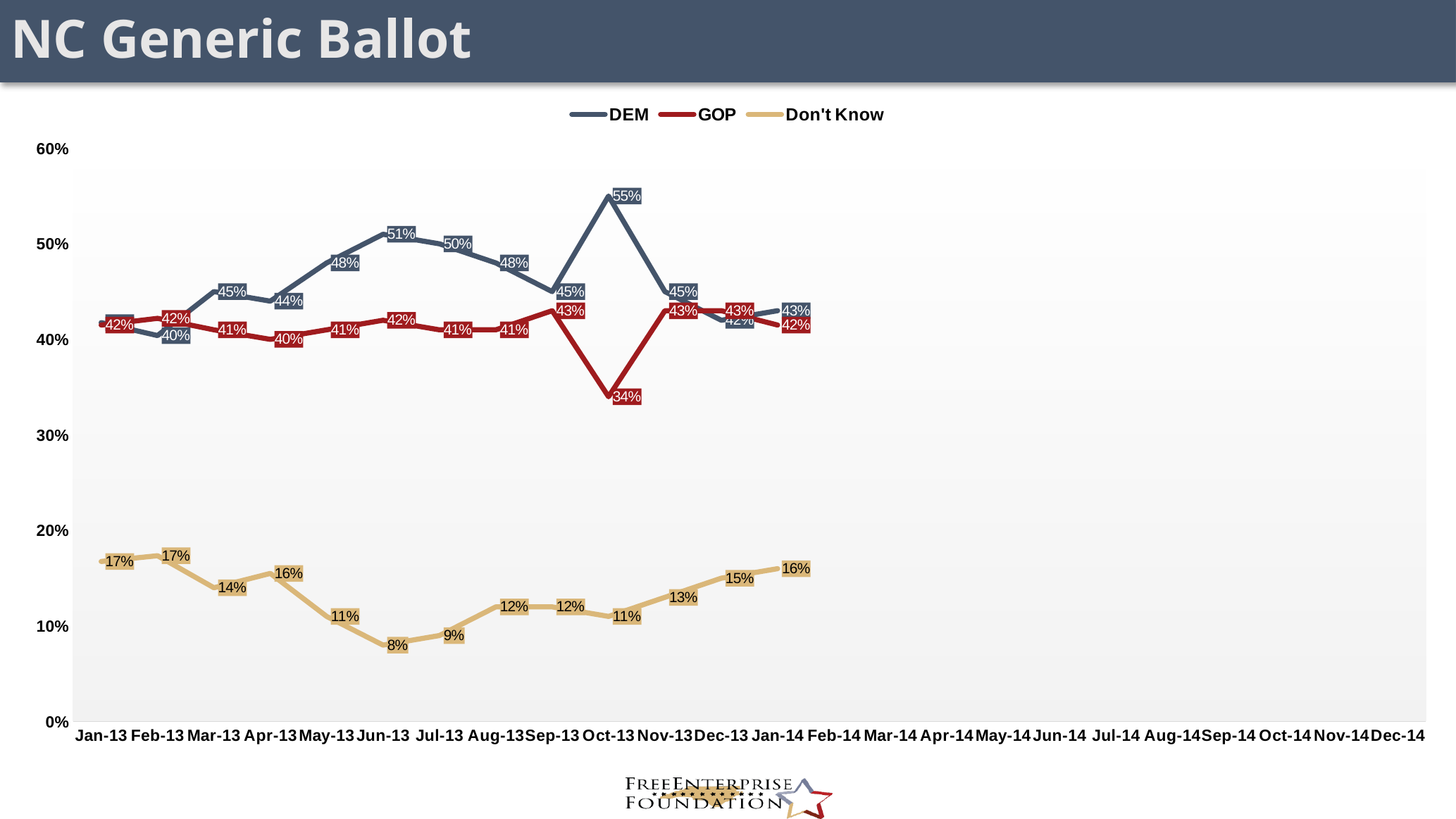
In which month does the DEM series reach its highest value? Oct-13 What is the difference between the DEM and GOP values in Oct-13? 21% How many series does the legend list? 3 What type of chart is shown on the slide? Line chart What is the Don't Know value for Jun-13? 8% In which month does the GOP series reach its lowest value? Oct-13 What is the title of the chart? NC Generic Ballot What is the DEM value for Oct-13? 55% Which is larger in Dec-13, the DEM value or the GOP value? GOP What is the Don't Know value for Jan-14? 16% Does the Don't Know series rise or fall from Jun-13 to Jan-14? Rise What is the GOP value for Oct-13? 34%